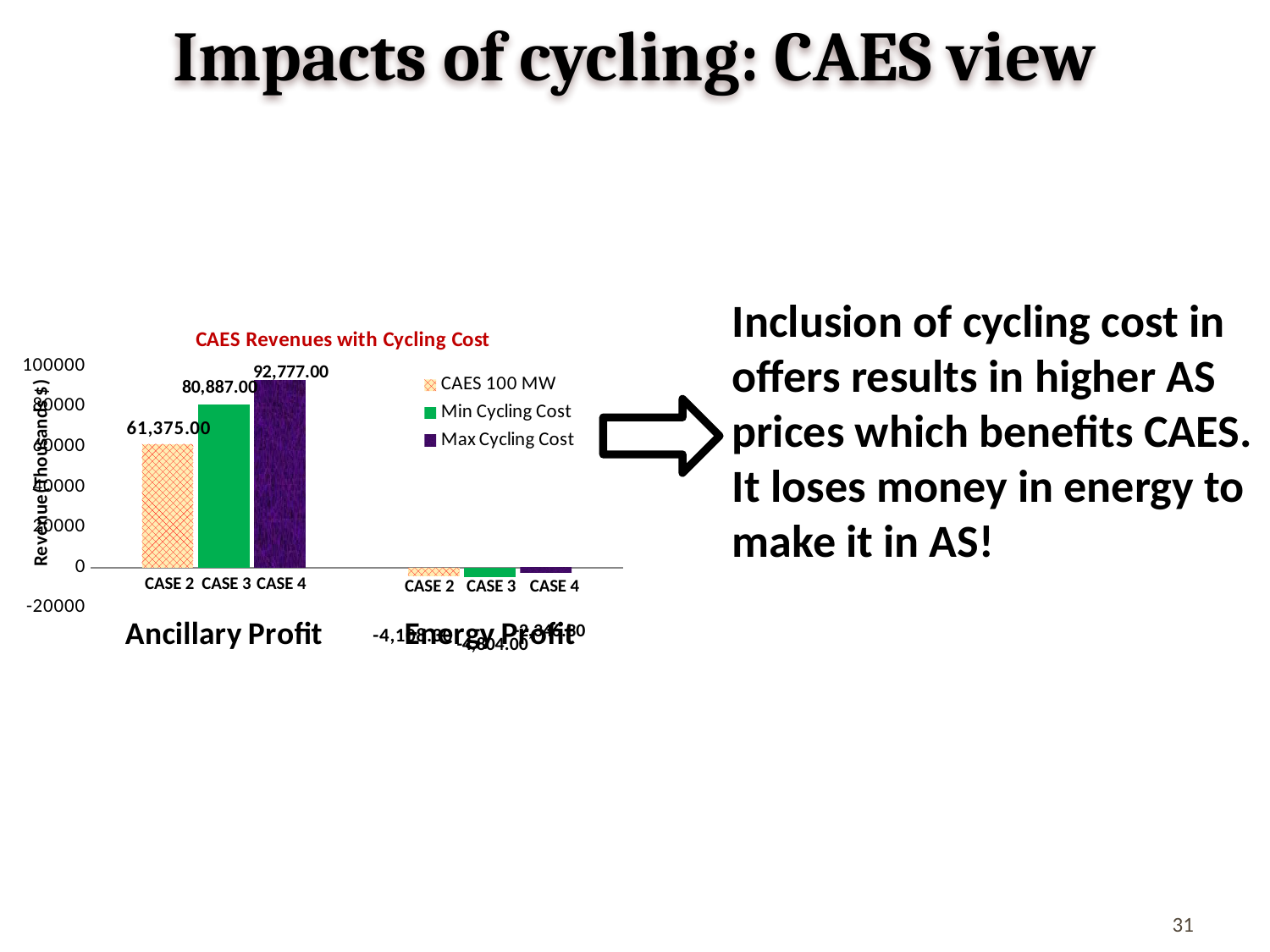
Which case has the lowest Ancillary Profit? CASE 2 Is the Ancillary Profit for CASE 2 greater or less than 80000? less What kind of chart is shown on the slide? bar chart What is the Ancillary Profit value for CASE 3? 80,887.00 How many series does the legend list? 3 Which case has the highest Ancillary Profit? CASE 4 What is the Ancillary Profit value for CASE 4? 92,777.00 What is the difference between the Ancillary Profit of CASE 3 and CASE 2? 19,512.00 What is the Ancillary Profit value for CASE 2? 61,375.00 Is the Energy Profit for CASE 2 greater or less than 0? less What is the difference between the Ancillary Profit of CASE 4 and CASE 2? 31,402.00 Which is larger, the Ancillary Profit for CASE 3 or for CASE 4? CASE 4